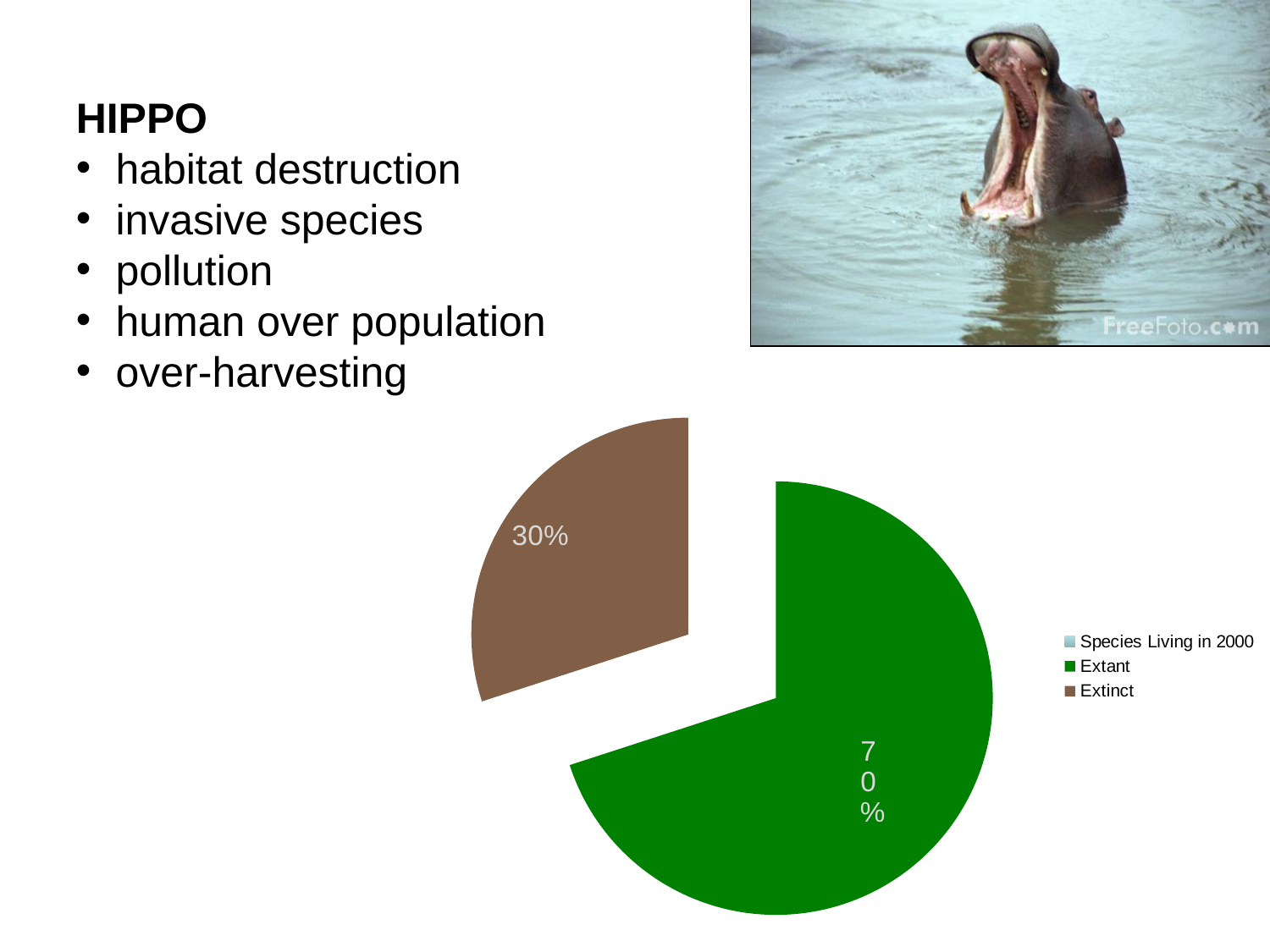
What colour is the Extinct slice in the pie chart? brown What kind of chart is shown on the slide? pie chart Which is larger in the pie chart, the Extant slice or the Extinct slice? Extant How many entries does the legend of the pie chart list? 3 How many slices are visible in the pie chart? 2 What colour is the Extant slice in the pie chart? green What percentage of the pie chart is labelled for the Extant slice? 70% What do the two labelled slices of the pie chart add up to? 100% Which slice of the pie chart is the largest? Extant What percentage of the pie chart is labelled for the Extinct slice? 30% By how many percentage points does the Extant slice exceed the Extinct slice? 40 percentage points Which labelled slice of the pie chart is the smallest? Extinct